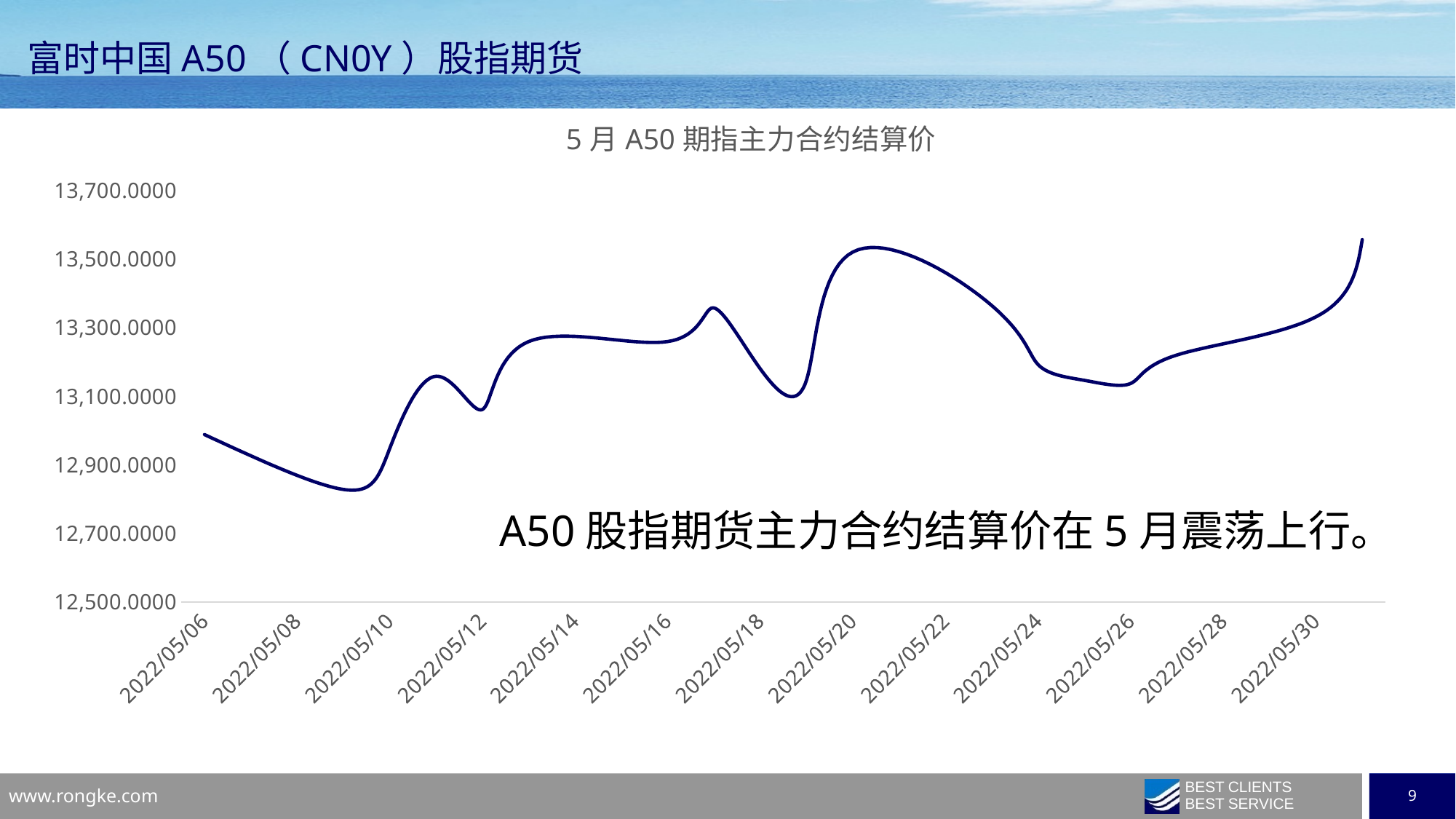
Which is larger, the value at 2022/05/06 or the value at 2022/05/20? 2022/05/20 Around which x-axis date does the line reach its lowest value? 2022/05/10 What kind of chart is shown on the slide? line chart How many lines are plotted on the chart? 1 Overall, does the settlement price rise or fall from 2022/05/06 to the end of the chart? rise Is the value at 2022/05/06 greater or less than 13,100.0000? less What is the highest value shown on the y axis? 13,700.0000 Is the value at 2022/05/20 greater or less than 13,300.0000? greater How many date labels are shown on the x axis? 13 Is the value at 2022/05/26 greater or less than 13,300.0000? less What is the title of the chart? 5月A50期指主力合约结算价